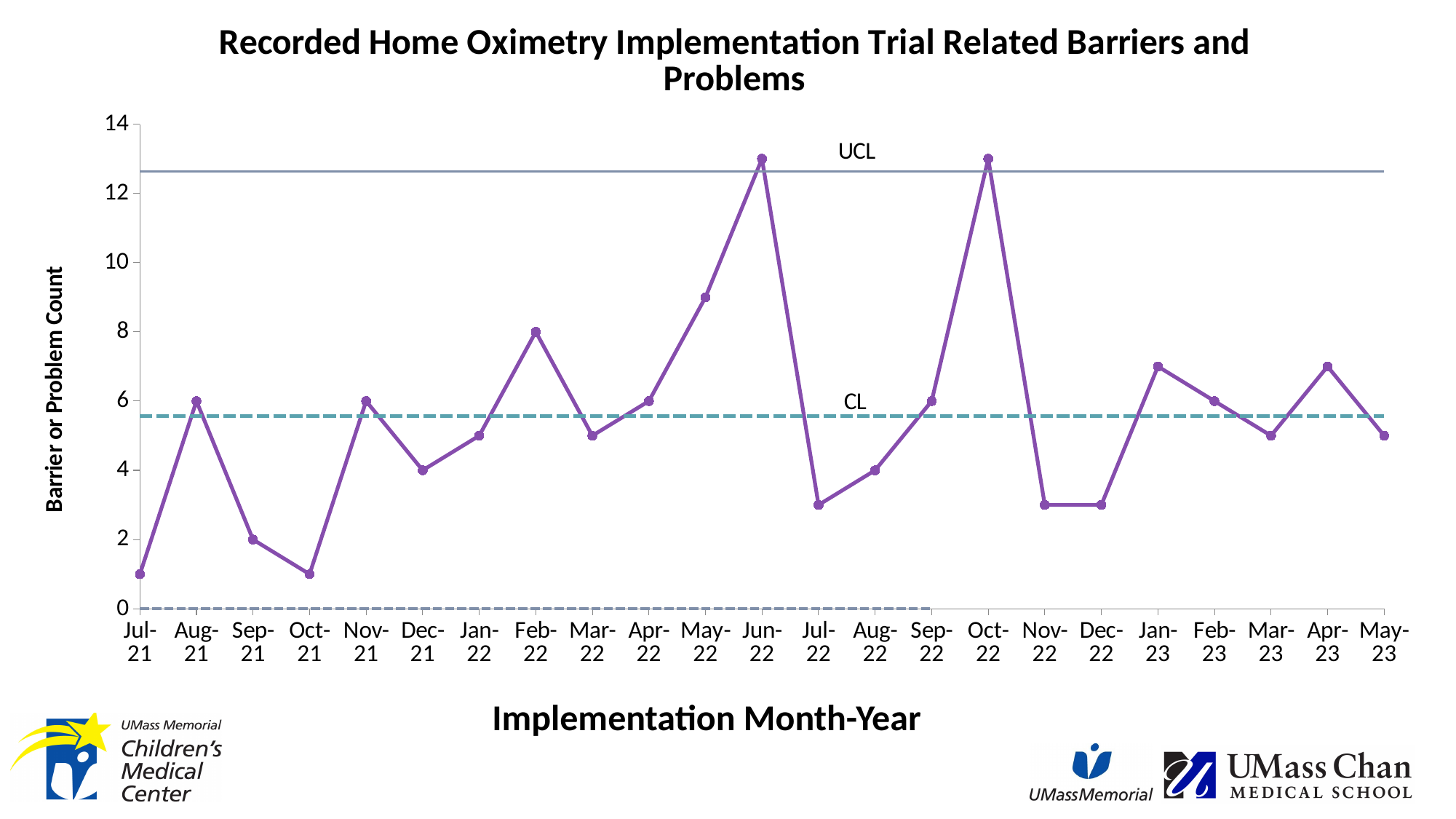
How many months are plotted on the x axis? 23 What is the difference between the barrier or problem counts for Feb-22 and Dec-21? 4 Is the value for Jun-22 greater or less than 12? greater Is the value for Jul-22 greater or less than 4? less What is the barrier or problem count for Sep-21? 2 What is the barrier or problem count for Aug-21? 6 What is the barrier or problem count for Dec-21? 4 Which has a higher barrier or problem count, Feb-22 or Dec-21? Feb-22 Is the value for May-22 greater or less than 8? greater What is the barrier or problem count for Feb-22? 8 What is the title of the x axis? Implementation Month-Year What kind of chart is shown on the slide? line chart